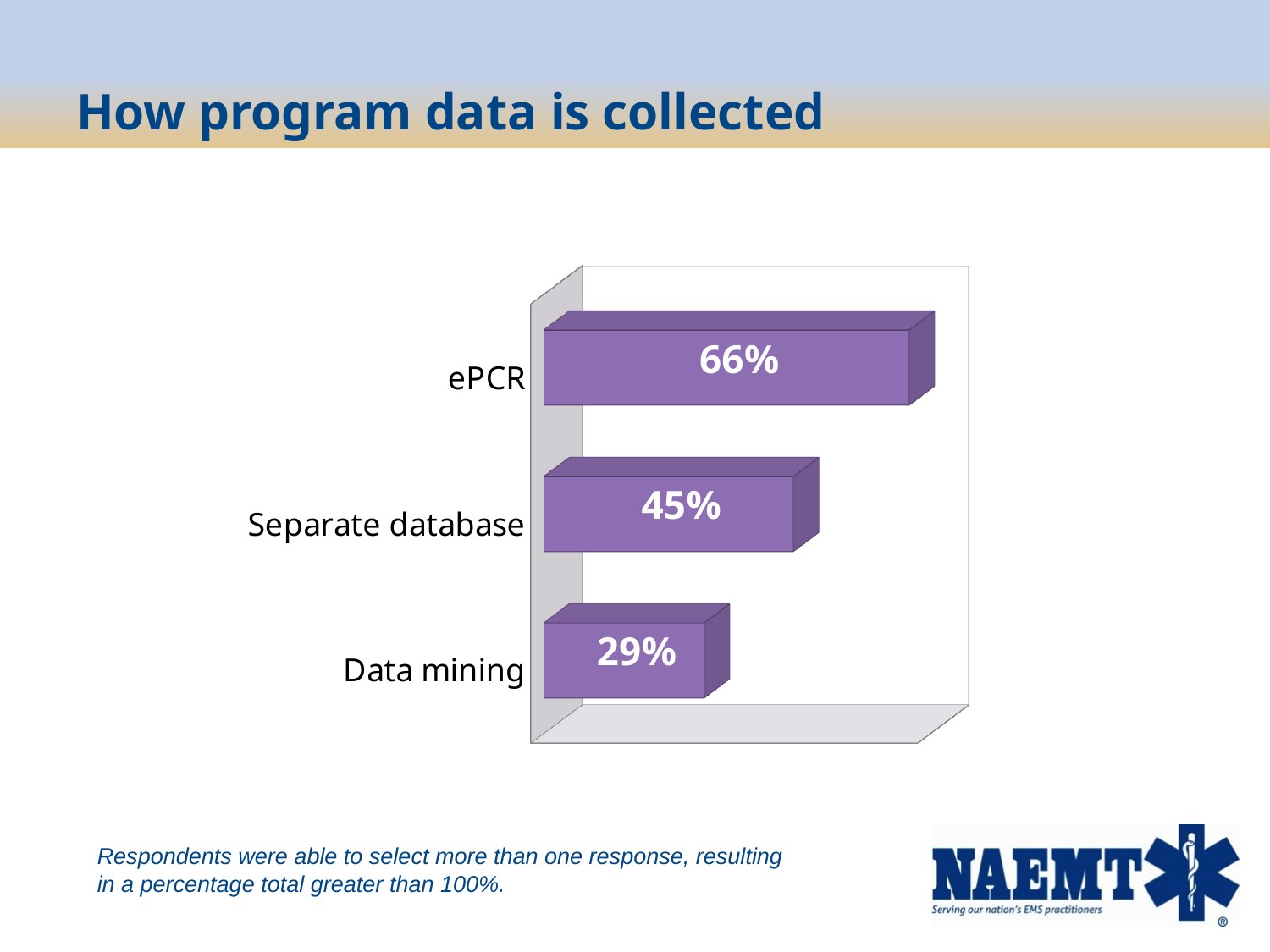
What colour are the bars in the chart? Purple What is the value shown for Data mining? 29% Which data collection method has the highest percentage? ePCR What kind of chart is shown on the slide? Bar chart Which data collection method has the lowest percentage? Data mining How many data collection methods are shown in the chart? 3 What is the difference in percentage points between ePCR and Separate database? 21 What is the title of the slide containing the chart? How program data is collected Which is larger, the value for Separate database or the value for Data mining? Separate database What percentage of respondents collect program data via ePCR? 66% What is the difference in percentage points between Separate database and Data mining? 16 What is the value shown for Separate database? 45%